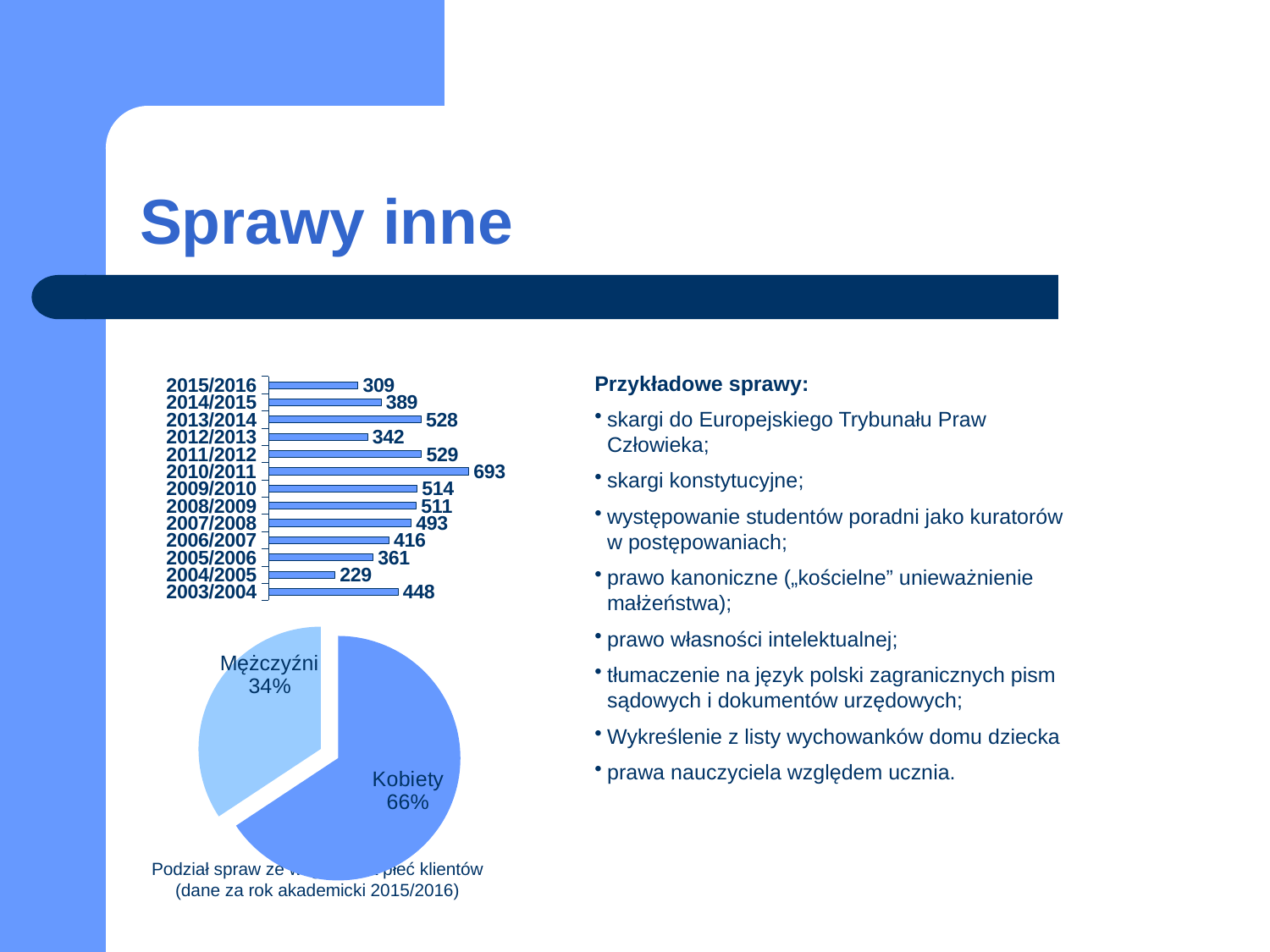
In the bar chart at the top left of the slide, what is the difference between the values for 2013/2014 and 2012/2013? 186 In the bar chart at the top left of the slide, what is the value for 2010/2011? 693 What kind of chart is the chart at the top left of the slide? bar chart In the pie chart at the bottom left of the slide, what share is labelled Kobiety? 66% How many slices does the pie chart at the bottom left of the slide have? 2 In the bar chart at the top left of the slide, which year has the highest value? 2010/2011 How many years (categories) are shown in the bar chart at the top left of the slide? 13 In the bar chart at the top left of the slide, which is larger: the value for 2006/2007 or the value for 2005/2006? 2006/2007 In the bar chart at the top left of the slide, what is the value for 2003/2004? 448 In the bar chart at the top left of the slide, which year has the lowest value? 2004/2005 In the bar chart at the top left of the slide, what is the value for 2015/2016? 309 In the pie chart at the bottom left of the slide, what share is labelled Mężczyźni? 34%